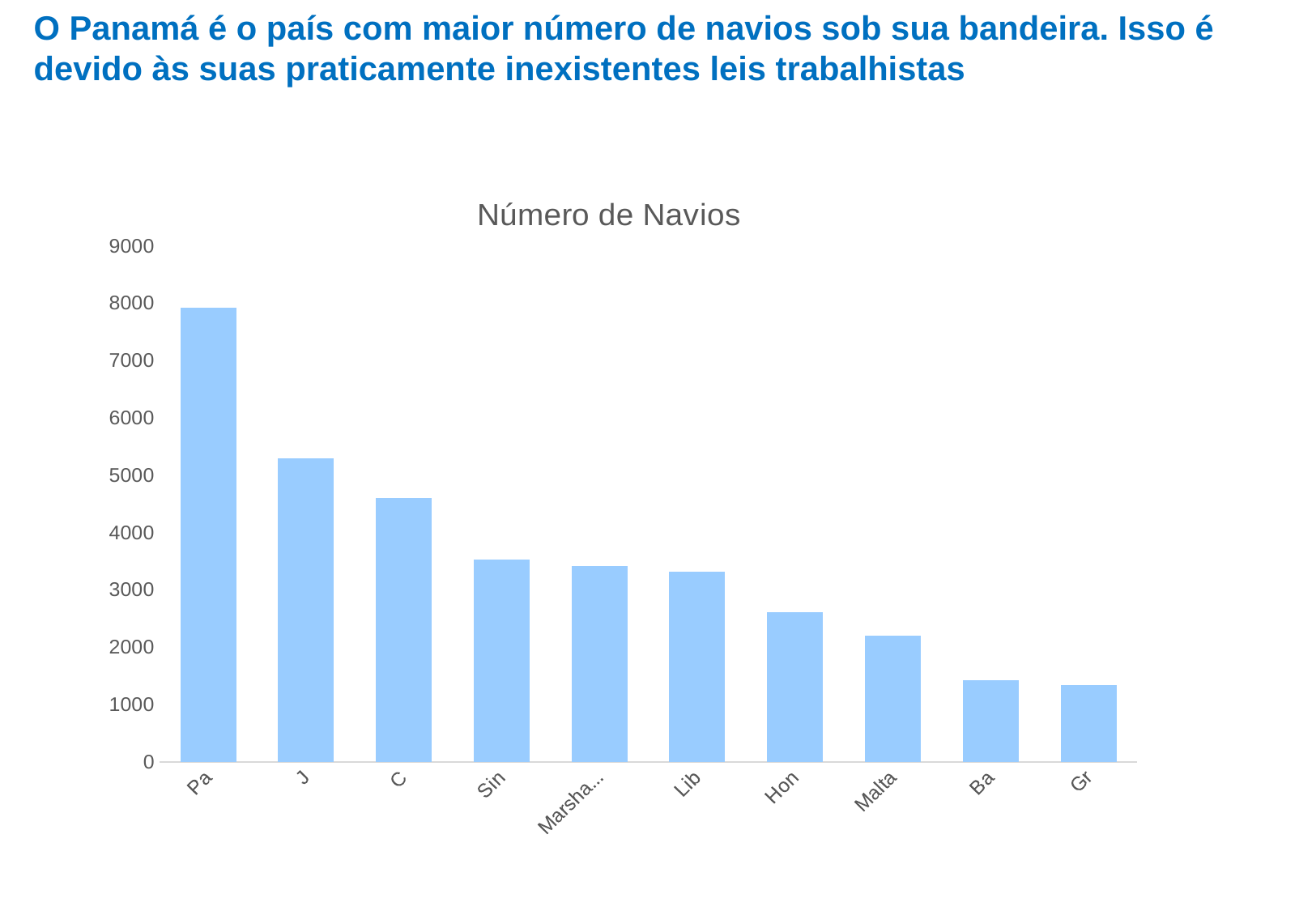
Is the value for Pa greater or less than 7000? greater Is the value for C greater or less than 5000? less Is the value for J greater or less than 5000? greater What is the title of the chart? Número de Navios What kind of chart is shown on the slide? bar chart Which is larger, the value for Hon or the value for Malta? Hon Do the values rise or fall from left to right along the x axis? fall How many bars (categories) does the chart show? 10 Which category has the highest value in the chart? Pa Which is larger, the value for Pa or the value for J? Pa